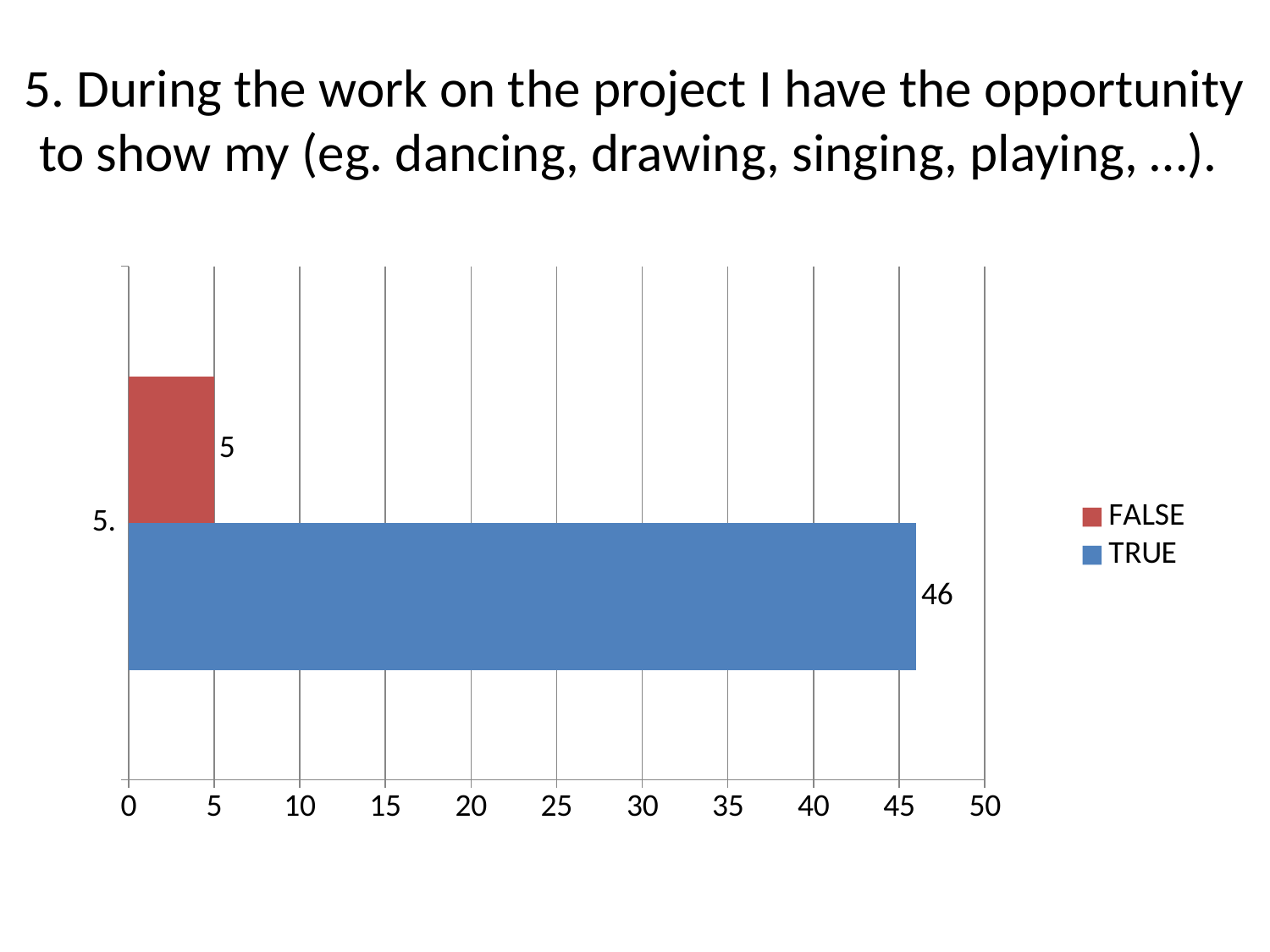
Which series has the higher value, TRUE or FALSE? TRUE What colour is the bar for TRUE? blue Which series has the lowest value? FALSE Is the value for TRUE greater or less than 40? greater How many series does the legend list? 2 What is the value for FALSE? 5 What is the difference between the TRUE and FALSE values? 41 What is the maximum value shown on the horizontal axis? 50 What is the value for TRUE? 46 Is the value for FALSE greater or less than 10? less What kind of chart is shown on the slide? bar chart What is the total of the TRUE and FALSE values? 51